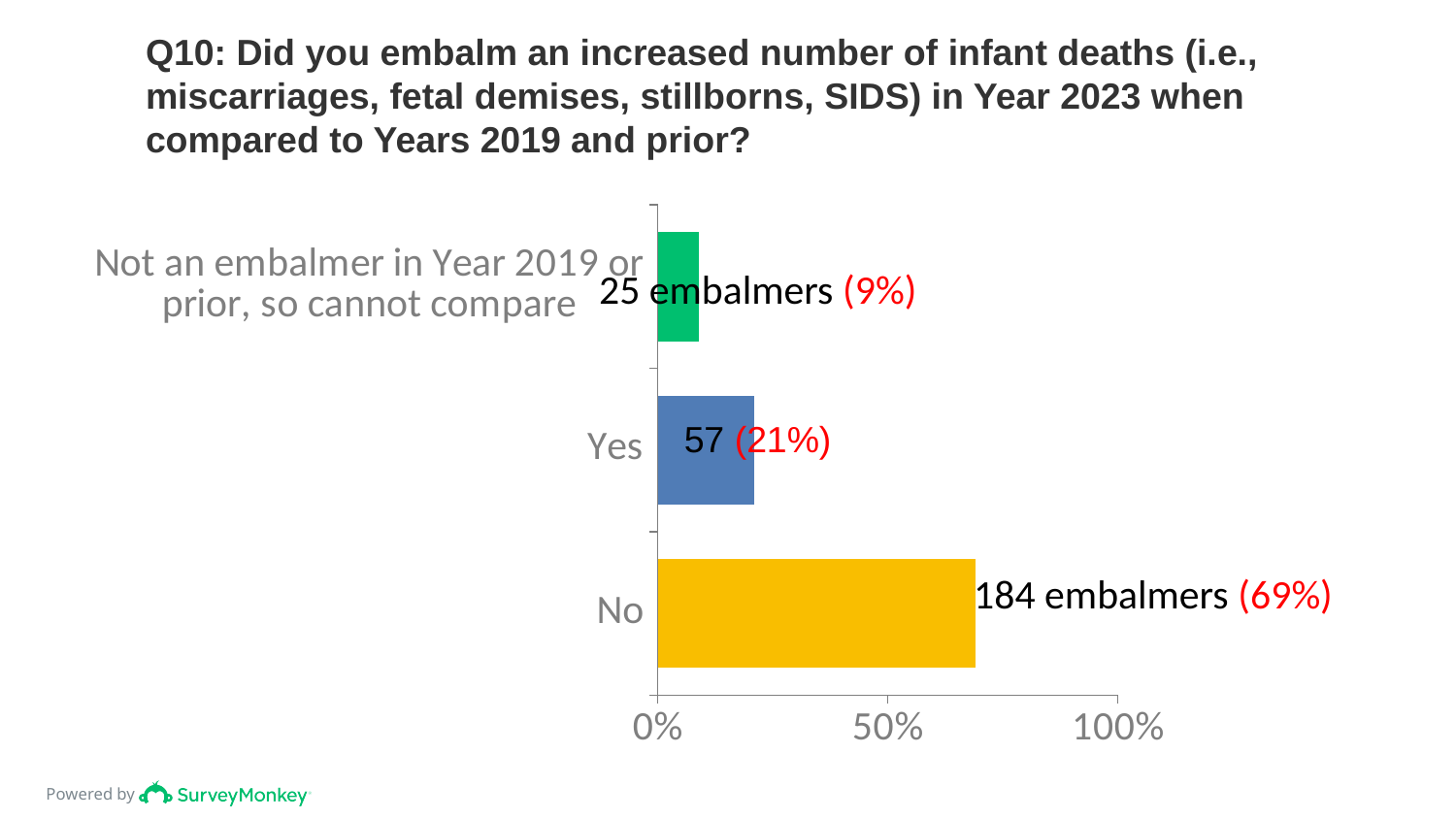
What colour is the bar for the "No" response? Yellow Is the value for "No" greater or less than 50%? greater How many embalmers answered "Yes"? 57 What percentage of respondents answered "No"? 69% Which is larger, the share for "Yes" or the share for "Not an embalmer in Year 2019 or prior, so cannot compare"? Yes What is the difference in percentage points between the "No" and "Yes" responses? 48 Which response category has the lowest share? Not an embalmer in Year 2019 or prior, so cannot compare How many response categories are shown in the chart? 3 How many embalmers selected "Not an embalmer in Year 2019 or prior, so cannot compare"? 25 What kind of chart is shown on the slide? Bar chart Which response category has the highest share? No What percentage of respondents answered "Yes"? 21%